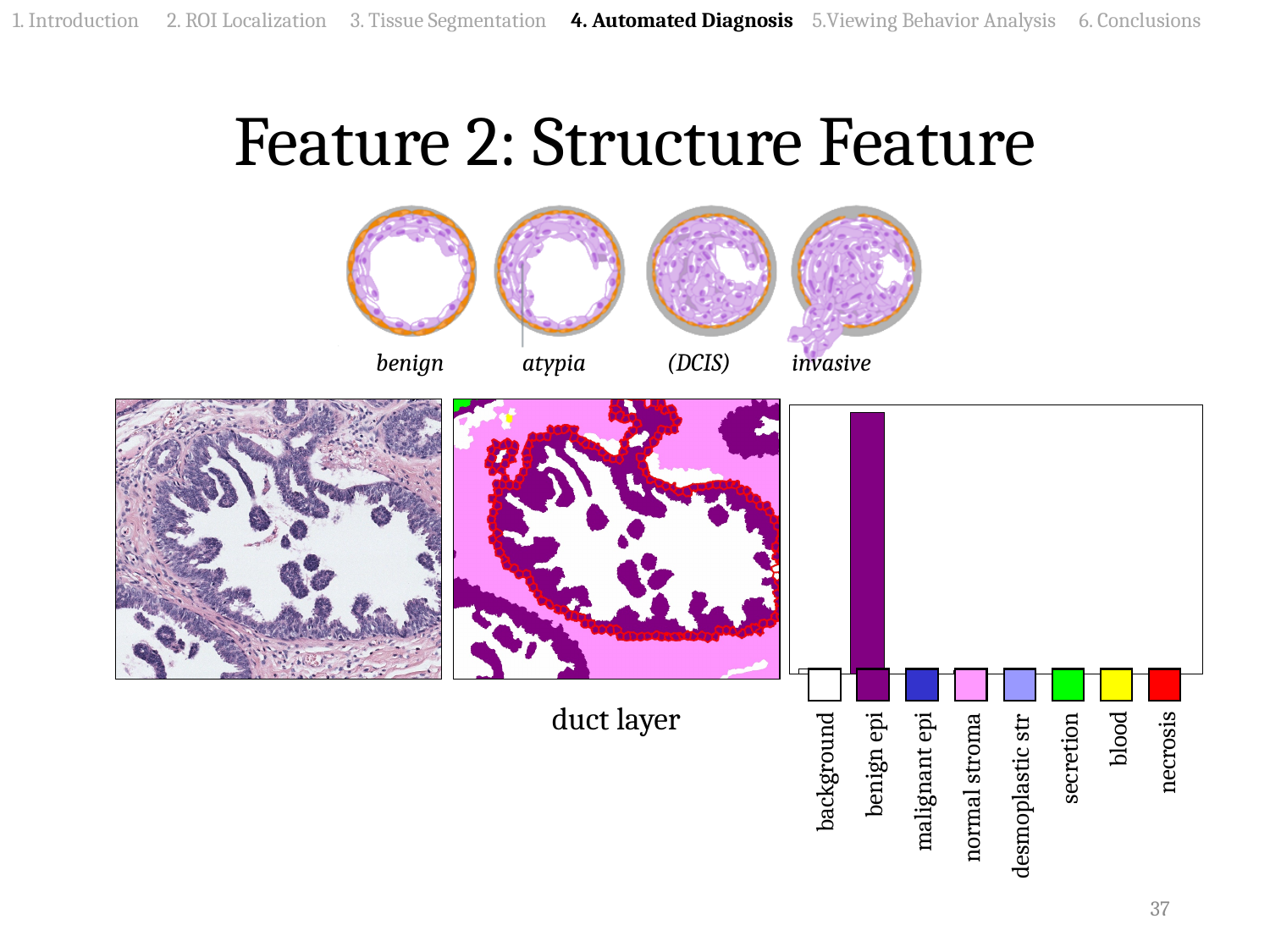
In the bar chart, which is larger, the value for benign epi or the value for malignant epi? benign epi In the bar chart, which is larger, the value for benign epi or the value for necrosis? benign epi Which category has the highest bar in the bar chart? benign epi What kind of chart is shown on the right side of the slide? bar chart What colour is the bar for benign epi in the bar chart? purple What is the first category listed on the x axis of the bar chart? background How many categories are shown on the x axis of the bar chart? 8 In the bar chart, which is larger, the value for benign epi or the value for normal stroma? benign epi